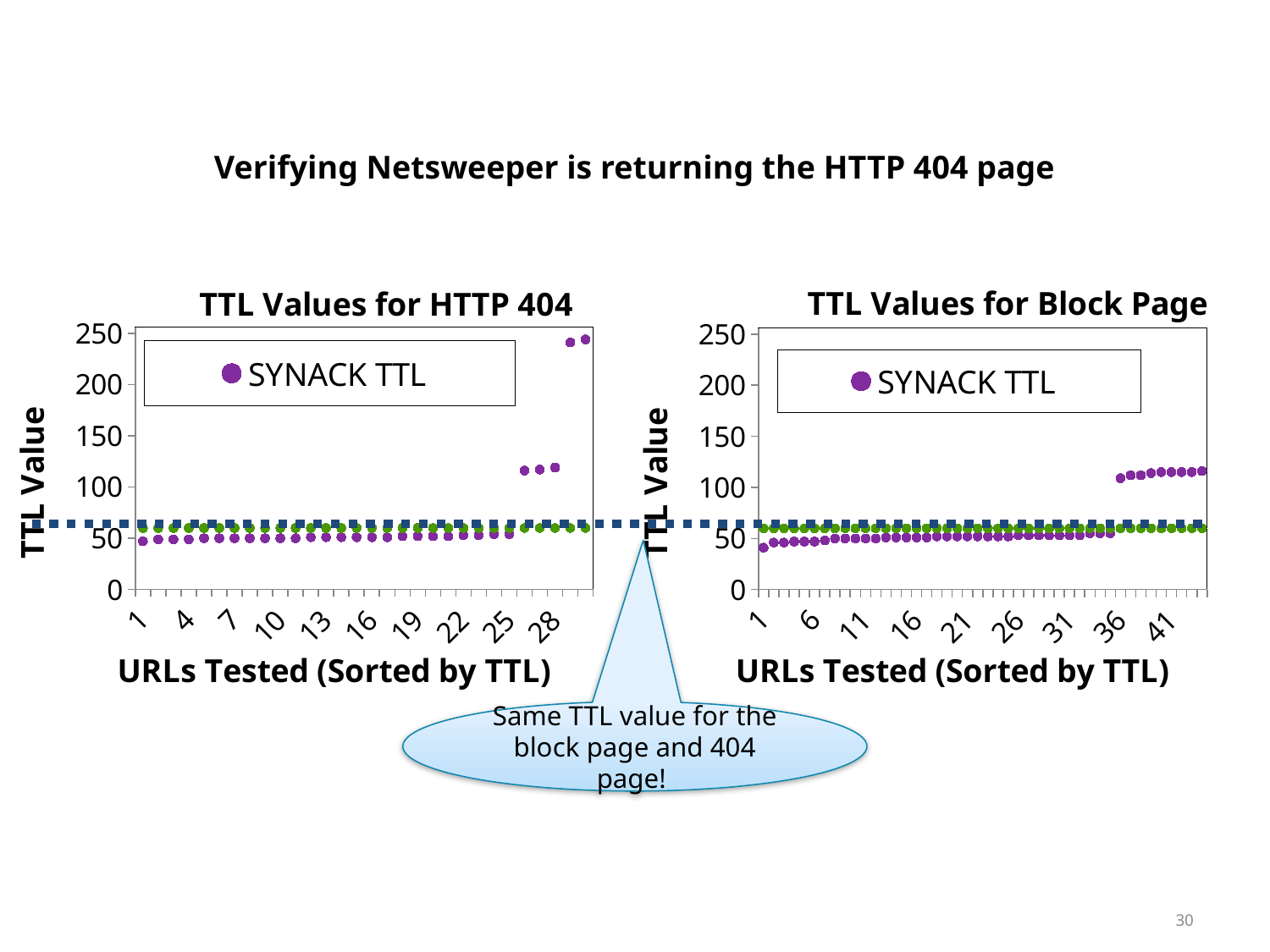
In the chart titled "TTL Values for HTTP 404", is the highest plotted TTL value greater or less than 200? greater In the chart titled "TTL Values for Block Page", how many series does the legend list? 1 In the chart titled "TTL Values for HTTP 404", is the value for URL 10 greater or less than 100? less In the chart titled "TTL Values for Block Page", do the TTL values rise or fall as you move along the x axis? rise In the chart titled "TTL Values for HTTP 404", what is the name of the series shown in the legend? SYNACK TTL In the chart titled "TTL Values for Block Page", is the highest plotted TTL value greater or less than 150? less Which chart has the higher maximum plotted TTL value, "TTL Values for HTTP 404" or "TTL Values for Block Page"? TTL Values for HTTP 404 In the chart titled "TTL Values for Block Page", what is the label on the x axis? URLs Tested (Sorted by TTL) In the chart titled "TTL Values for HTTP 404", do the TTL values rise or fall as you move along the x axis? rise In the chart titled "TTL Values for HTTP 404", what kind of chart is used to plot the data? scatter chart